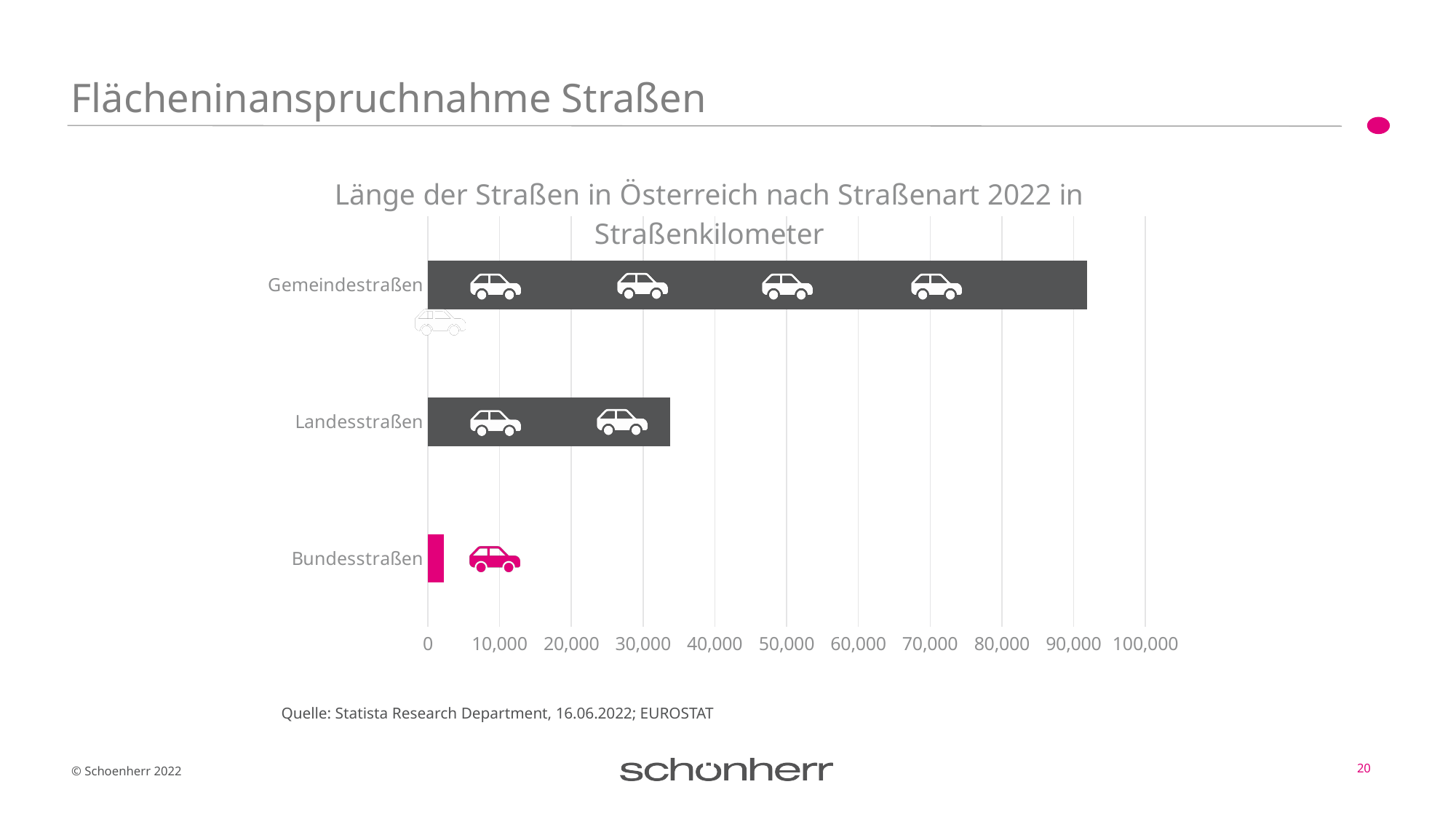
Is the value for Bundesstraßen greater or less than 10,000? less What kind of chart is shown on the slide? bar chart Is the value for Landesstraßen greater or less than 30,000? greater What is the title of the chart? Länge der Straßen in Österreich nach Straßenart 2022 in Straßenkilometer How many road categories are plotted in the chart? 3 Is the value for Gemeindestraßen greater or less than 90,000? greater What colour is the bar for Bundesstraßen? pink Which has a greater road length, Gemeindestraßen or Landesstraßen? Gemeindestraßen Which road category has the longest road length? Gemeindestraßen Which road category has the shortest road length? Bundesstraßen Which has a greater road length, Landesstraßen or Bundesstraßen? Landesstraßen